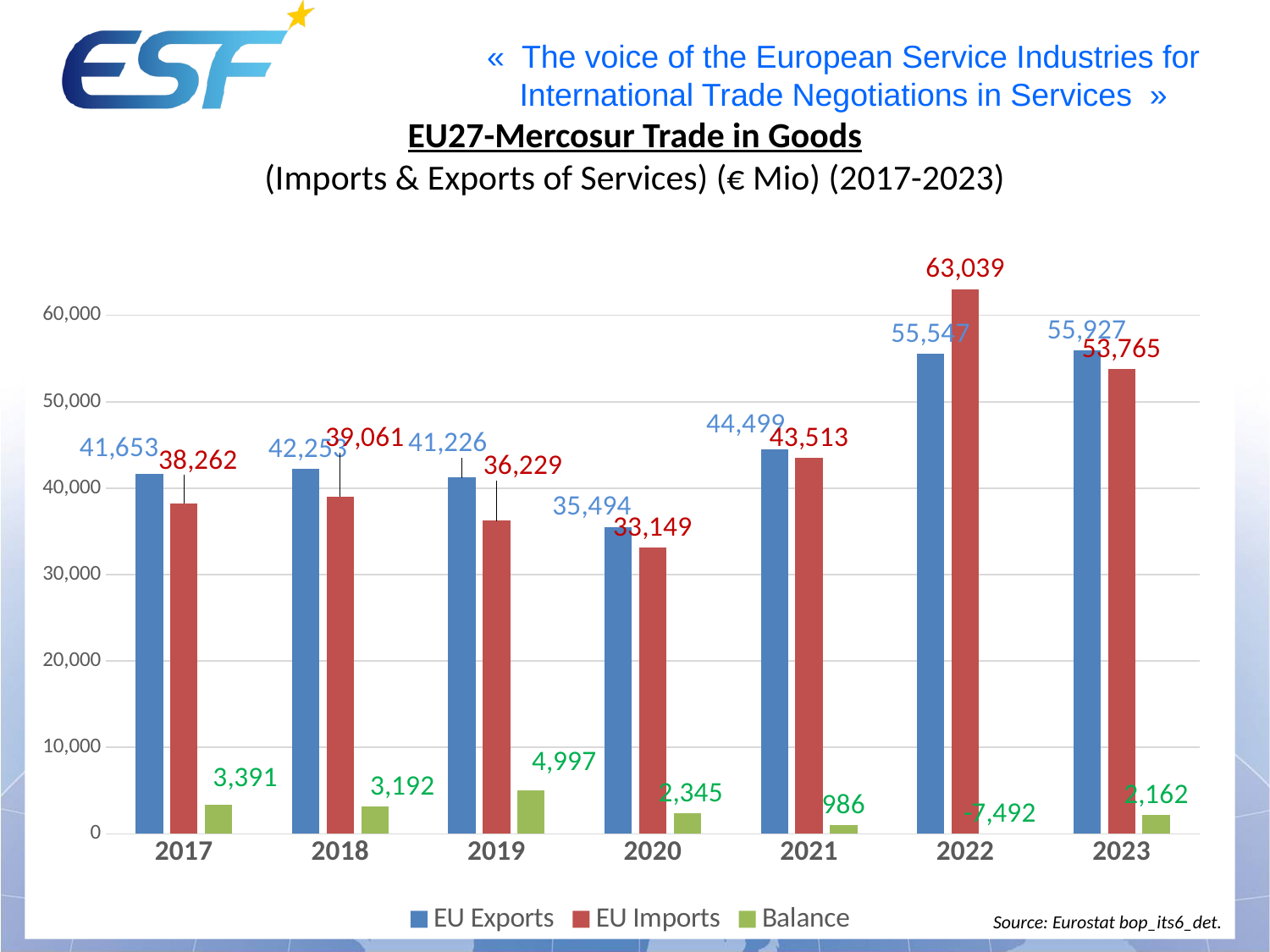
What is the Balance value for 2022? -7,492 What is the difference between EU Exports and EU Imports in 2017? 3,391 What is the Balance value for 2019? 4,997 What kind of chart is shown on the slide? bar chart Is the value for EU Imports in 2020 greater or less than 40,000? less In which year are EU Imports highest? 2022 How many years are shown on the x axis? 7 In which year are EU Exports lowest? 2020 What is the value of EU Exports in 2017? 41,653 How many series does the legend list? 3 What is the value of EU Imports in 2022? 63,039 In 2021, which is larger: EU Exports or EU Imports? EU Exports